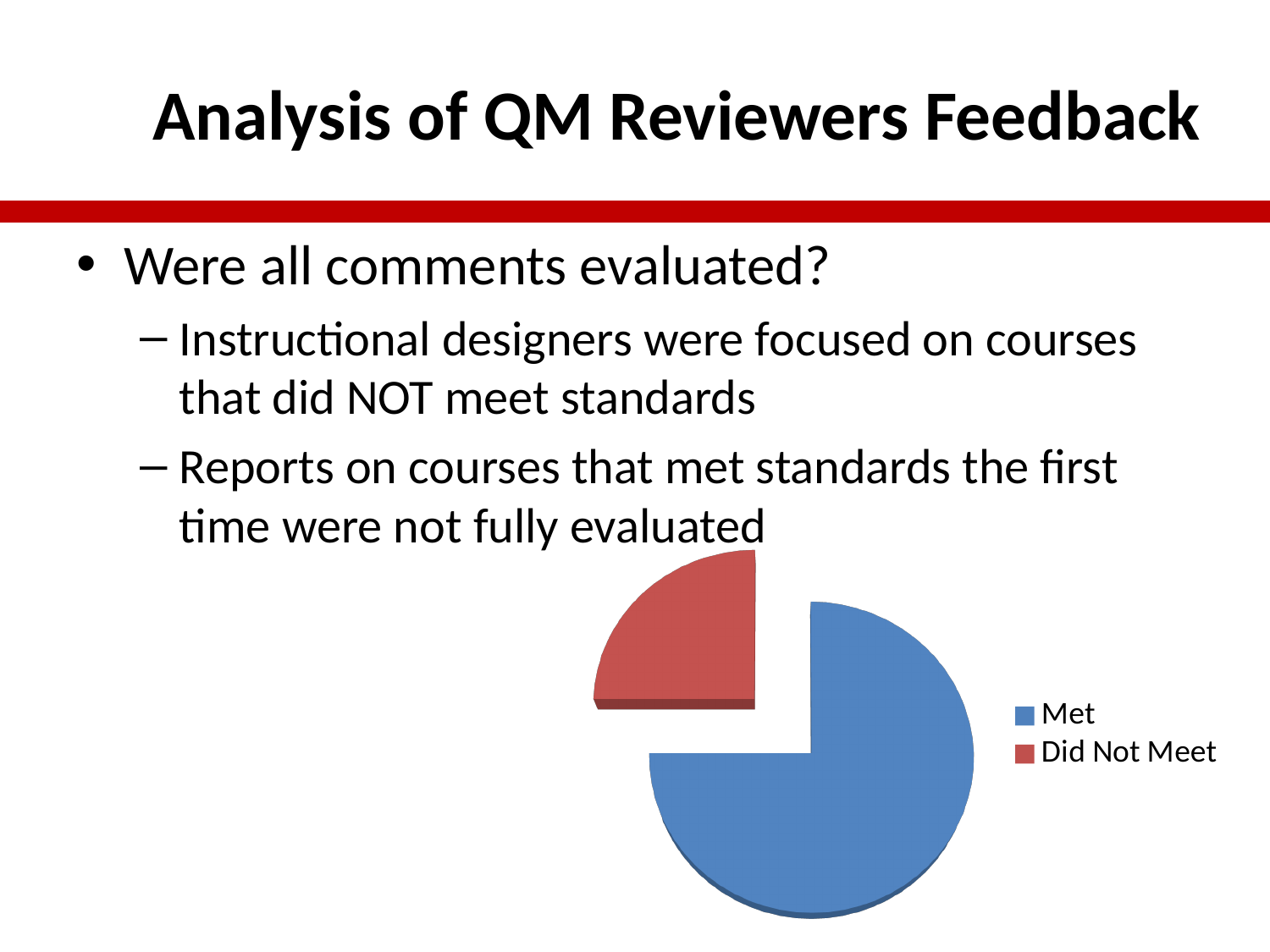
What colour is the Did Not Meet slice in the pie chart? red What colour is the Met slice in the pie chart? blue How many entries does the legend of the pie chart list? 2 Which category has the largest slice in the pie chart? Met Which category has the smallest slice in the pie chart? Did Not Meet How many slices does the pie chart have? 2 Which slice is larger in the pie chart, Met or Did Not Meet? Met What kind of chart is shown on the slide? pie chart